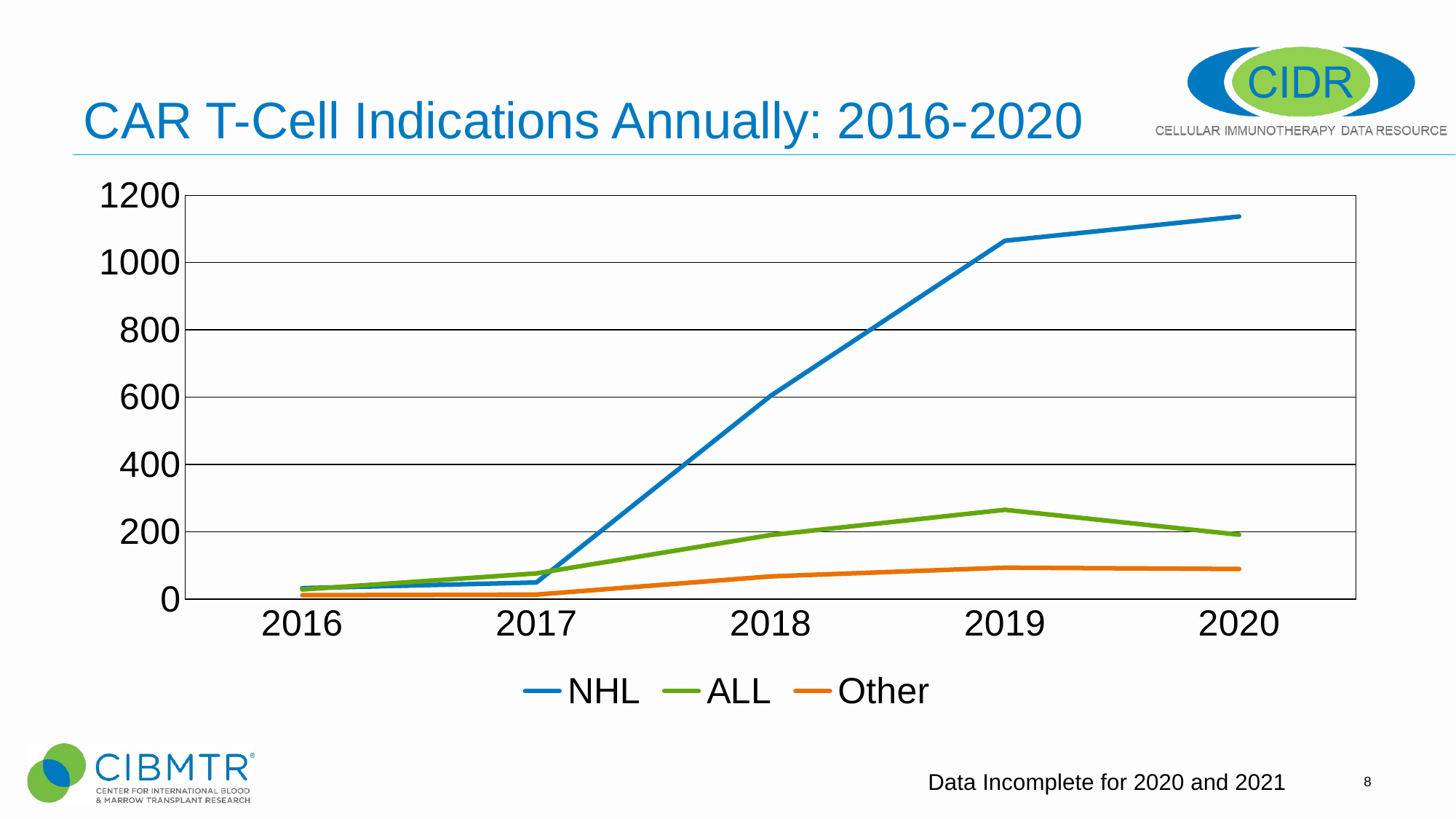
Is the value for ALL in 2019 greater or less than 400? less In which year does the NHL series reach its highest value? 2020 What kind of chart is shown on the slide? line chart Which series has the lowest value in 2019? Other How many series does the legend list? 3 Is the value for NHL in 2018 greater or less than 400? greater In which year does the ALL series reach its highest value? 2019 Which is larger in 2018, the value for ALL or the value for Other? ALL Does the NHL series rise or fall from 2017 to 2019? rise How many years are shown along the x axis? 5 Which series has the highest value in 2020? NHL Is the value for NHL in 2019 greater or less than 1000? greater